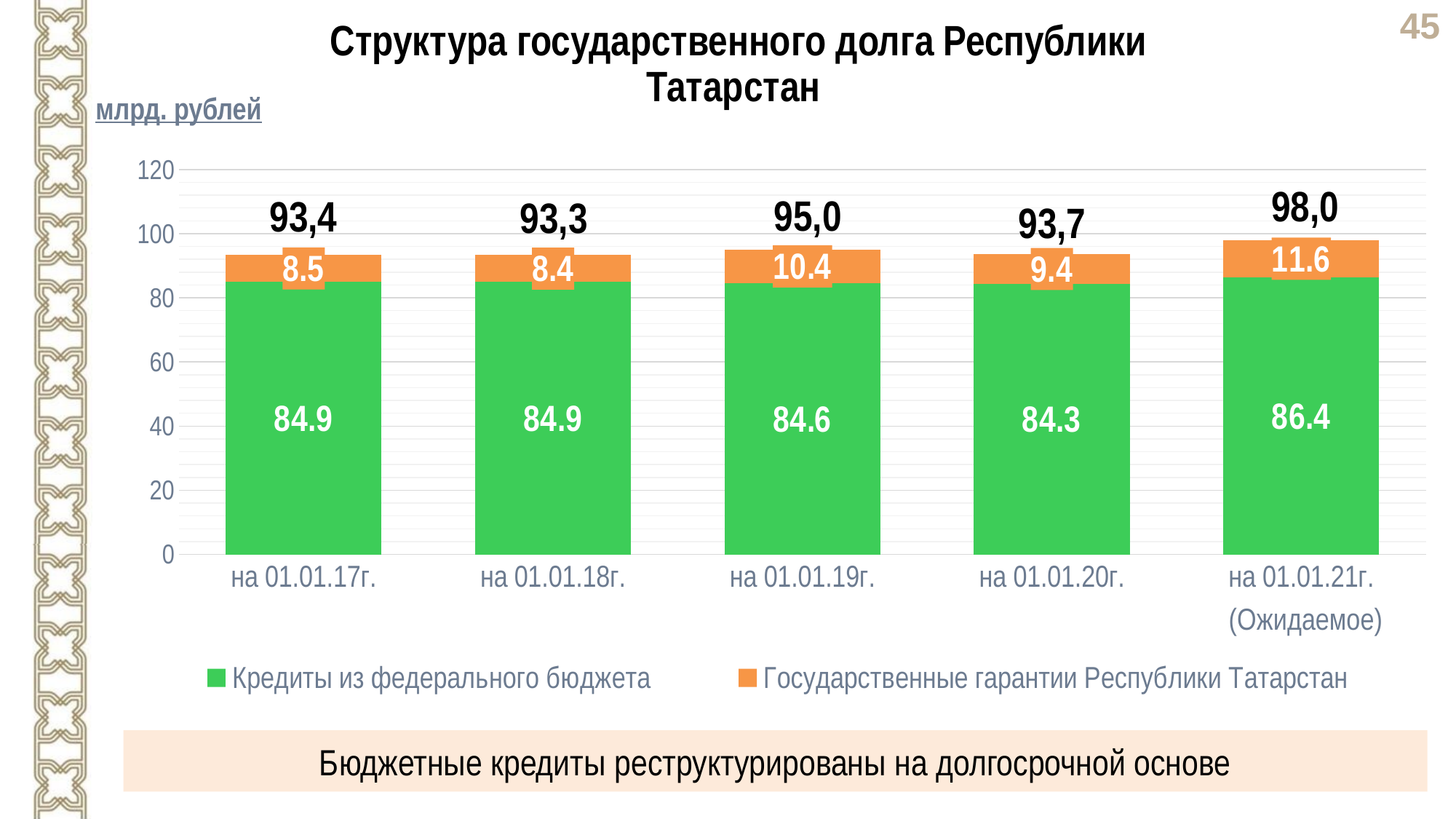
What kind of chart is shown on the slide? Stacked bar chart Which is larger: the Государственные гарантии Республики Татарстан value for на 01.01.19г. or for на 01.01.20г.? на 01.01.19г. How many series does the legend list? 2 What is the value of Кредиты из федерального бюджета for на 01.01.19г.? 84.6 Which date has the lowest value for Кредиты из федерального бюджета? на 01.01.20г. What is the value of Государственные гарантии Республики Татарстан for на 01.01.18г.? 8.4 What is the value of Государственные гарантии Республики Татарстан for на 01.01.21г. (Ожидаемое)? 11.6 How many dates are shown on the x axis? 5 What is the difference between the Государственные гарантии Республики Татарстан values for на 01.01.21г. (Ожидаемое) and на 01.01.17г.? 3.1 Which date has the highest value for Государственные гарантии Республики Татарстан? на 01.01.21г. (Ожидаемое) What is the total of the stacked bar for на 01.01.21г. (Ожидаемое)? 98,0 What is the total of the stacked bar for на 01.01.19г.? 95,0